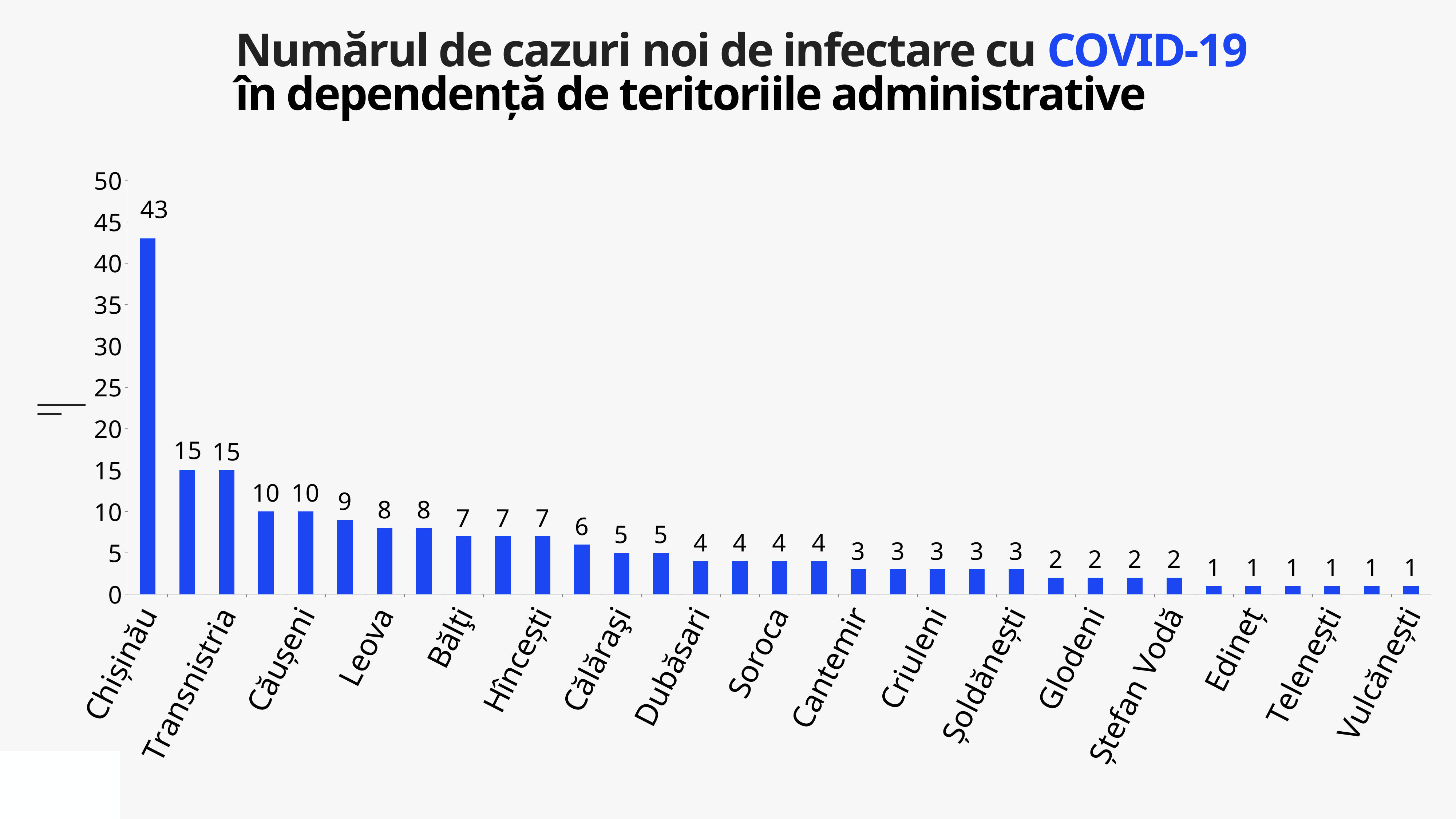
What is the value for Soroca? 4 Which territory has the highest number of new cases? Chișinău What is the value for Hîncești? 7 What is the value for Transnistria? 15 What kind of chart is shown on the slide? bar chart What is the value for Căușeni? 10 Which has a larger value, Căușeni or Soroca? Căușeni What is the value for Vulcănești? 1 Is the value for Chișinău greater or less than 40? greater What is the value for Chișinău? 43 Do the values rise or fall from left to right along the x axis? fall What is the difference between the values for Chișinău and Transnistria? 28